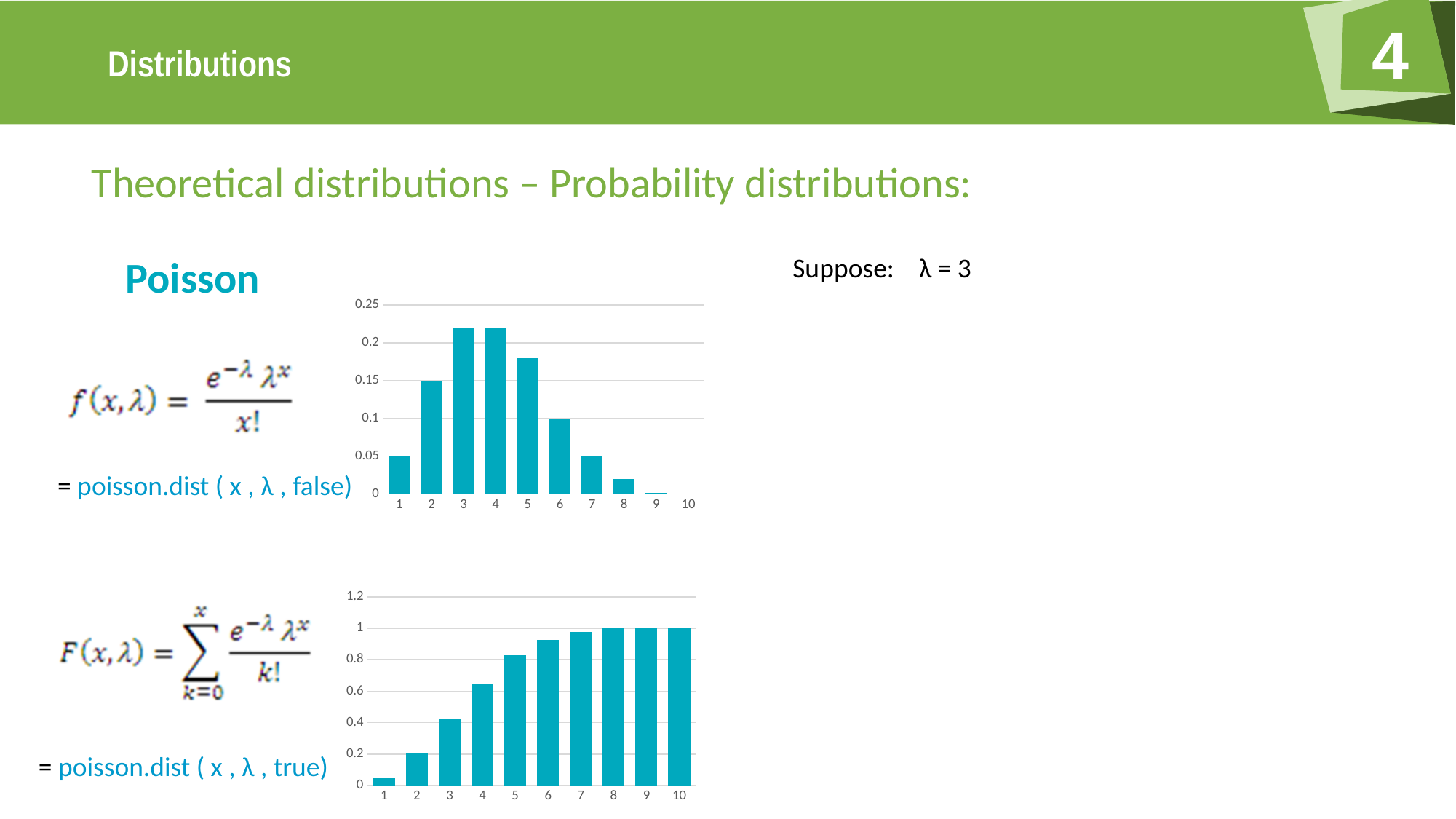
What kind of chart is the top chart on the slide? bar chart In the top chart, is the value for category 3 greater or less than 0.2? greater How many categories are shown on the x axis of the top chart? 10 What is the highest value labelled on the y axis of the bottom chart? 1.2 In the bottom chart, is the value for category 3 greater or less than 0.6? less In the bottom chart, is the value for category 4 greater or less than 0.6? greater In the top chart, which has the larger value, category 2 or category 7? category 2 In the bottom chart, do the values rise or fall as you move from category 1 to category 10? rise How many categories are shown on the x axis of the bottom chart? 10 In the bottom chart, which has the larger value, category 2 or category 5? category 5